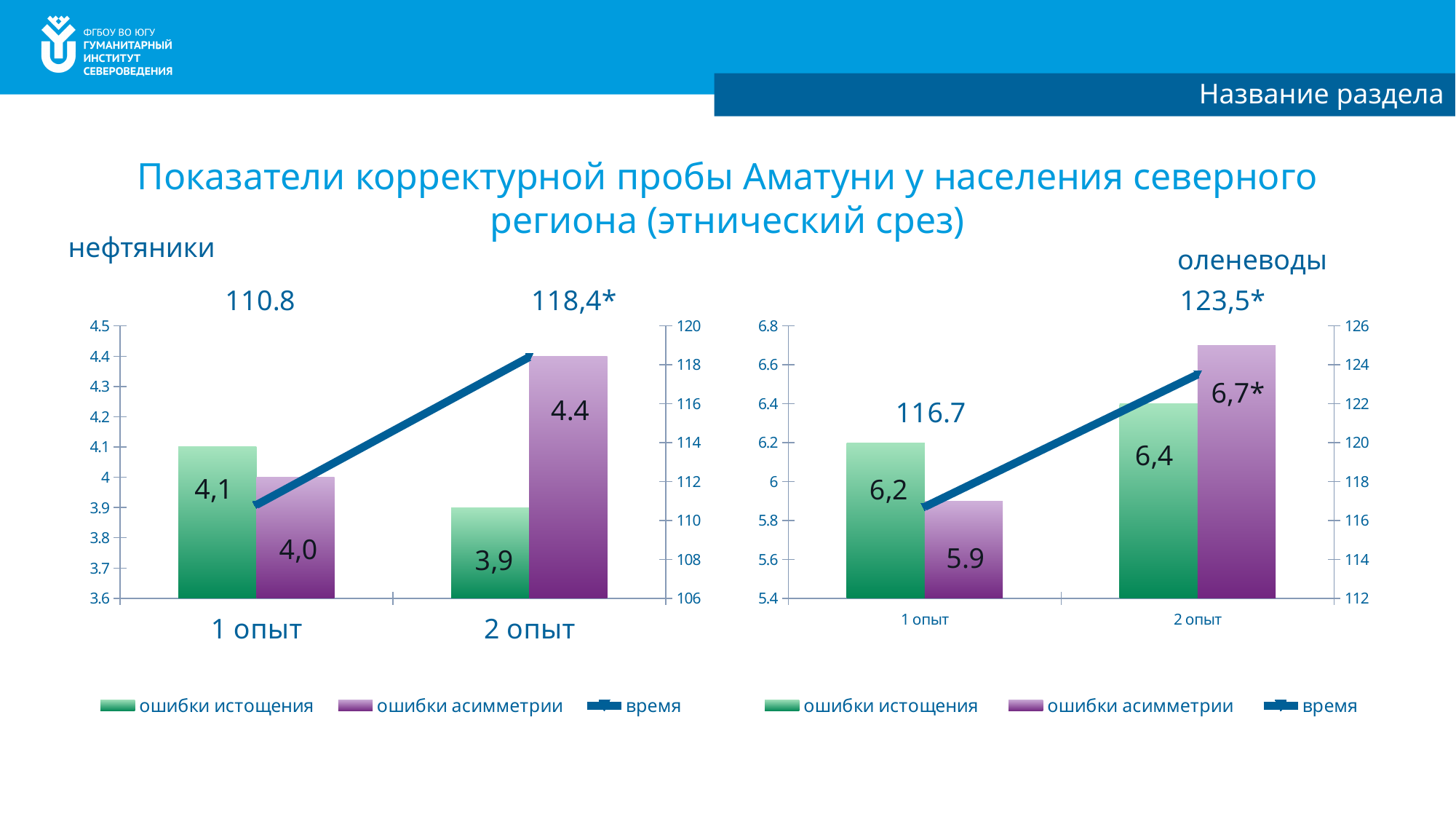
In the 'оленеводы' chart, which colour represents 'ошибки истощения'? green In the 'нефтяники' chart, what is the 'время' value for '2 опыт'? 118,4* In the 'нефтяники' chart, what is the value of 'ошибки истощения' for '1 опыт'? 4,1 In the 'нефтяники' chart, which is larger for '2 опыт': 'ошибки истощения' or 'ошибки асимметрии'? ошибки асимметрии In the 'оленеводы' chart, which category has the higher 'ошибки асимметрии' value? 2 опыт How many series does the legend of the 'оленеводы' chart list? 3 In the 'оленеводы' chart, what is the 'время' value for '1 опыт'? 116.7 In the 'нефтяники' chart, does the 'время' line rise or fall from '1 опыт' to '2 опыт'? rise In the 'нефтяники' chart, what is the value of 'ошибки асимметрии' for '2 опыт'? 4.4 How many categories are shown on the x axis of the 'нефтяники' chart? 2 In the 'оленеводы' chart, what is the value of 'ошибки асимметрии' for '1 опыт'? 5.9 In the 'оленеводы' chart, what is the value of 'ошибки истощения' for '2 опыт'? 6,4